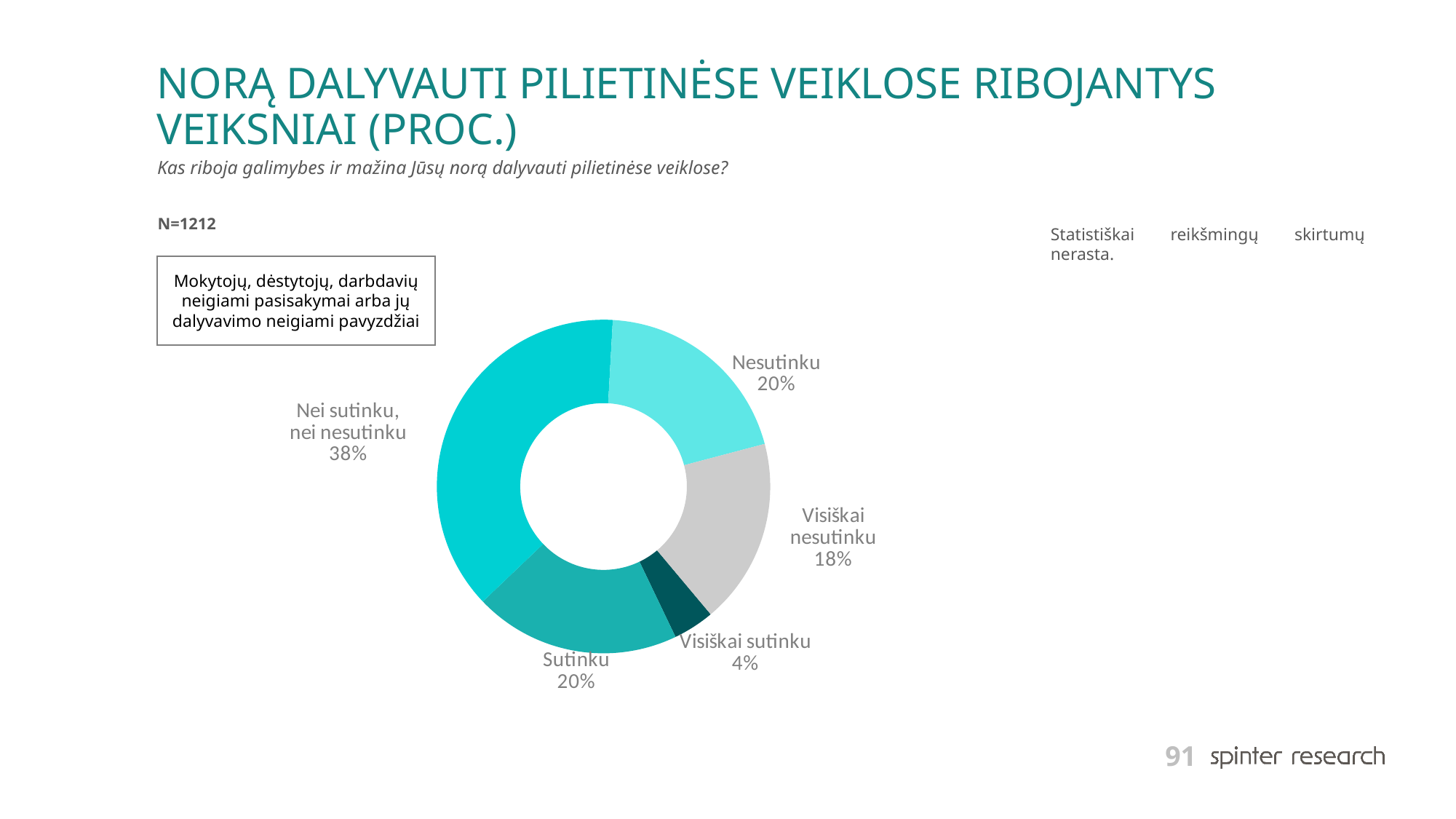
What kind of chart is shown on the slide? Pie chart (doughnut) Which response category has the largest share of the pie? Nei sutinku, nei nesutinku What is the difference in percentage points between "Nei sutinku, nei nesutinku" and "Nesutinku"? 18 What share of respondents answered "Sutinku"? 20% What share of respondents answered "Visiškai nesutinku"? 18% What share of respondents answered "Visiškai sutinku"? 4% Which response category has the smallest share of the pie? Visiškai sutinku What share of respondents answered "Nei sutinku, nei nesutinku"? 38% What is the sample size (N) stated on the slide? N=1212 Which is larger: the share for "Visiškai nesutinku" or the share for "Visiškai sutinku"? Visiškai nesutinku What is the combined share of "Sutinku" and "Visiškai sutinku"? 24% How many response categories are shown in the chart? 5